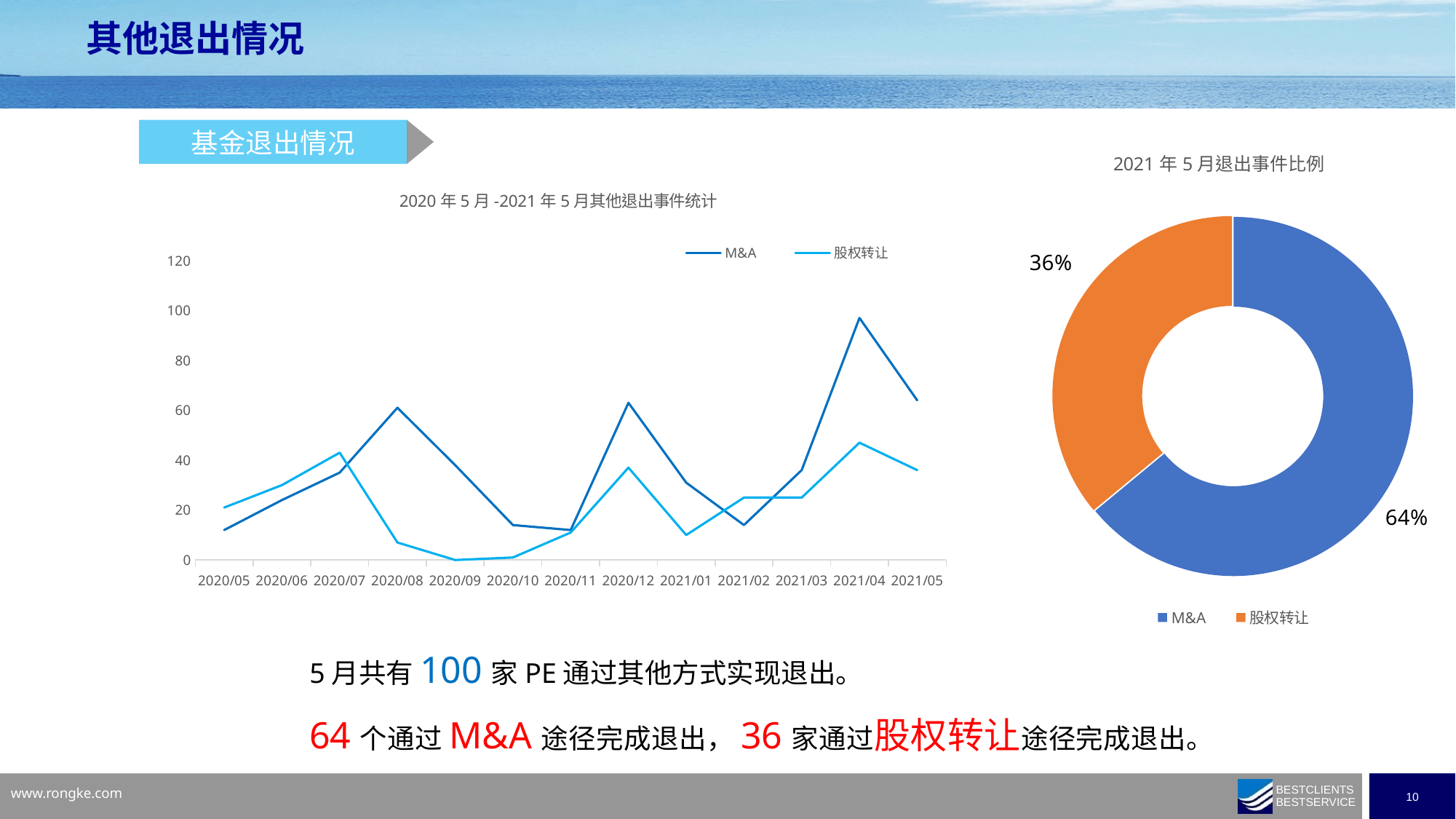
In the line chart 2020年5月-2021年5月其他退出事件统计, is the 股权转让 value for 2020/09 greater or less than 20? less In the line chart 2020年5月-2021年5月其他退出事件统计, which series has the larger value in 2020/08, M&A or 股权转让? M&A In the chart titled 2021年5月退出事件比例, what share does 股权转让 account for? 36% In the chart titled 2021年5月退出事件比例, which category has the largest share? M&A What kind of chart is the one titled 2020年5月-2021年5月其他退出事件统计? line chart How many series does the legend of the line chart 2020年5月-2021年5月其他退出事件统计 list? 2 How many months are plotted along the x axis of the line chart 2020年5月-2021年5月其他退出事件统计? 13 In the line chart 2020年5月-2021年5月其他退出事件统计, which series has the larger value in 2021/02, M&A or 股权转让? 股权转让 In the line chart 2020年5月-2021年5月其他退出事件统计, is the M&A value for 2021/04 greater or less than 80? greater In the line chart 2020年5月-2021年5月其他退出事件统计, in which month does the M&A series reach its highest value? 2021/04 In the line chart 2020年5月-2021年5月其他退出事件统计, does the M&A series rise or fall from 2021/04 to 2021/05? fall In the chart titled 2021年5月退出事件比例, what share does M&A account for? 64%